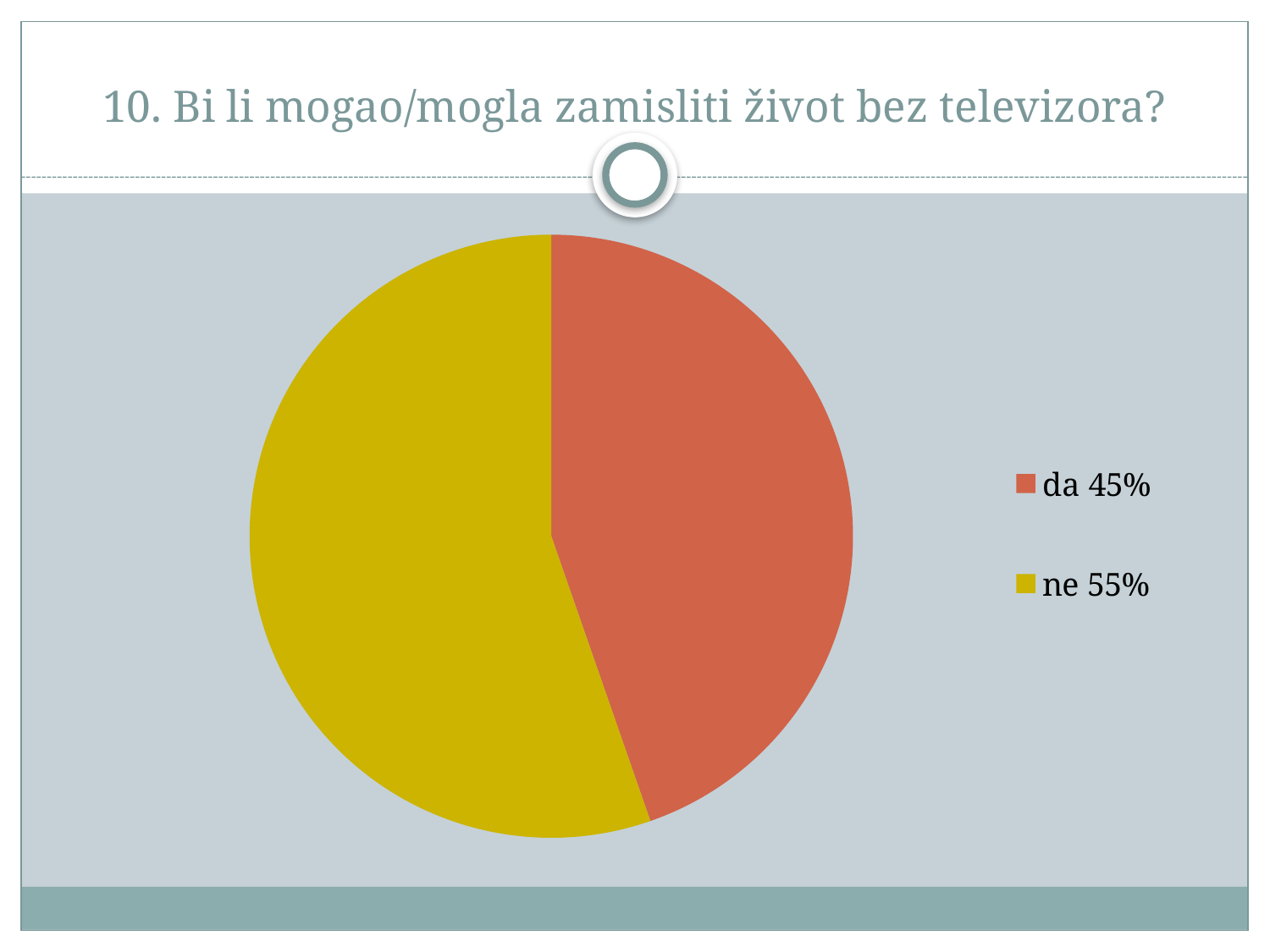
Which slice is the smallest? da How many entries does the legend list? 2 Which is larger, the share for "da" or the share for "ne"? ne What kind of chart is shown on the slide? pie chart What share of the pie does "ne" represent? 55% Which slice is the largest? ne What share of the pie does "da" represent? 45% What colour is the "ne" slice? yellow What is the difference in percentage points between the "ne" share and the "da" share? 10% How many slices does the pie chart have? 2 What colour is the "da" slice? red